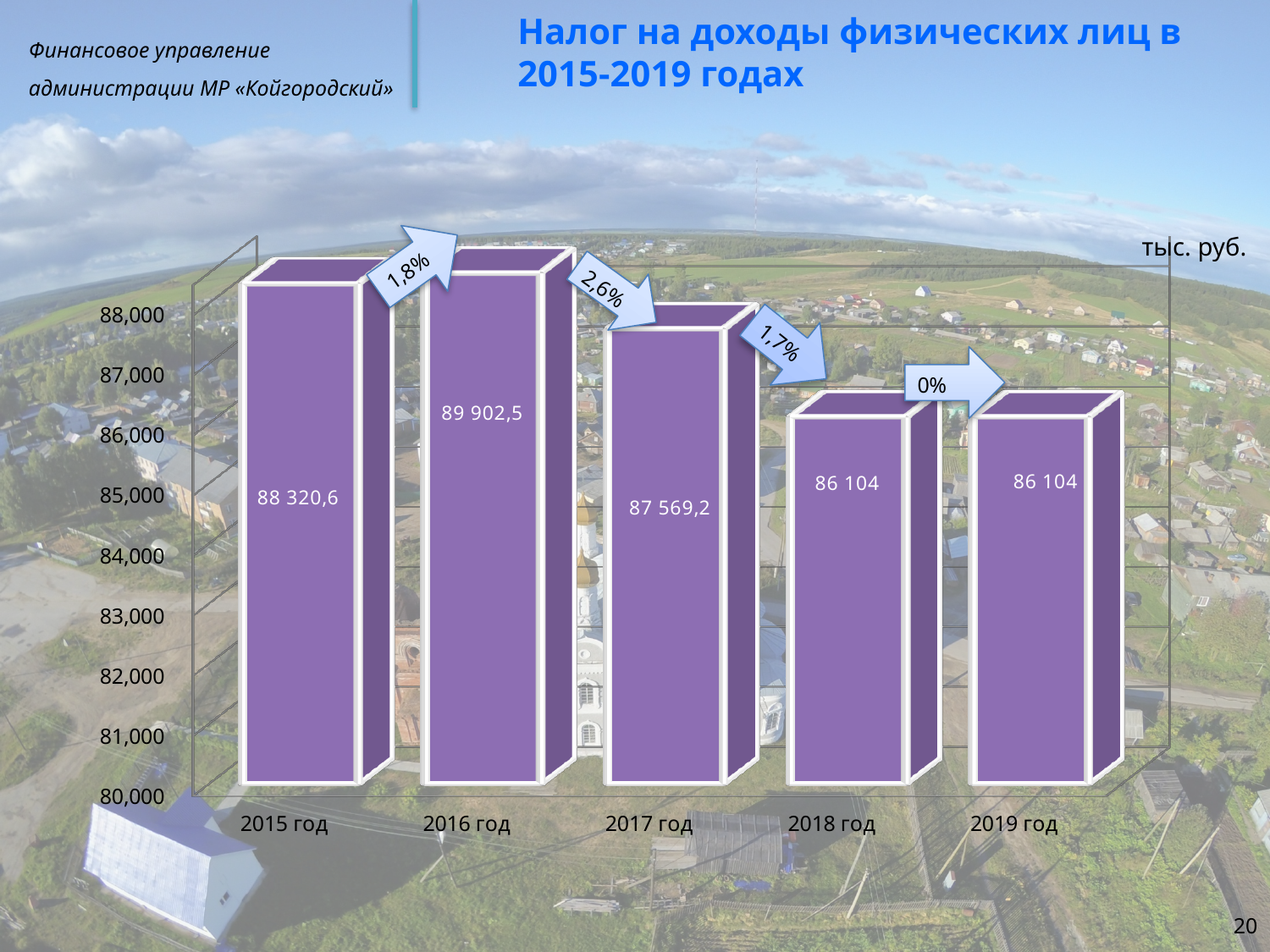
What is the value for 2016 год? 89 902,5 What is the difference between the values for 2016 год and 2015 год? 1 581,9 How many years are shown on the x axis? 5 What is the value for 2017 год? 87 569,2 Which year has the highest value? 2016 год What is the value for 2015 год? 88 320,6 What kind of chart is shown on the slide? bar chart What is the value for 2018 год? 86 104 What unit of measurement is indicated on the chart? тыс. руб. Is the value for 2019 год greater or less than 87,000? less What is the difference between the values for 2017 год and 2018 год? 1 465,2 Which is larger, the value for 2015 год or the value for 2017 год? 2015 год